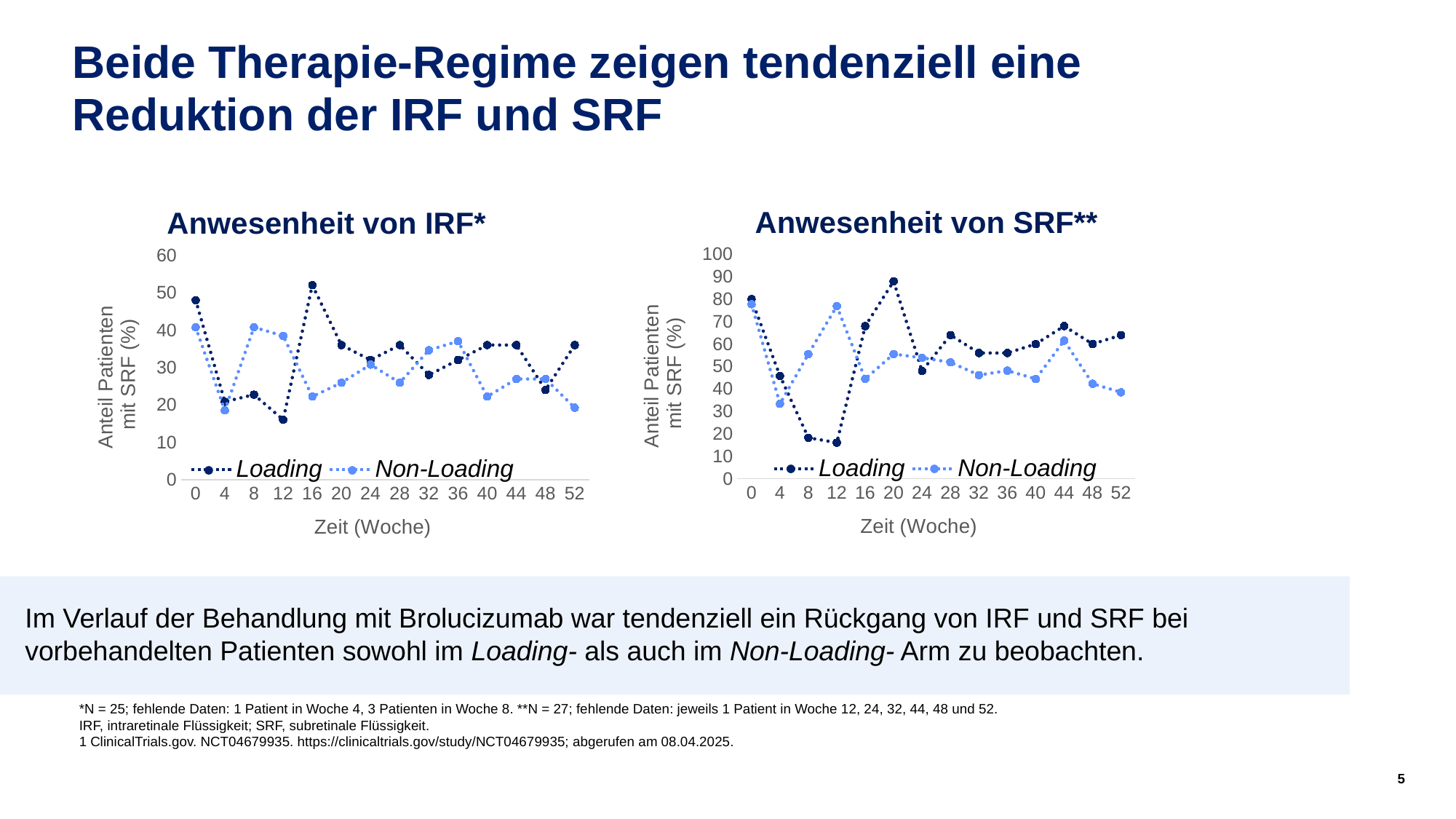
How many series does the legend of the "Anwesenheit von SRF**" chart list? 2 In the "Anwesenheit von SRF**" chart, which series has the higher value at week 12, Loading or Non-Loading? Non-Loading In the "Anwesenheit von SRF**" chart, is the Non-Loading value at week 12 greater or less than 70? greater In the "Anwesenheit von IRF*" chart, at which week does the Loading series reach its lowest value? 12 In the "Anwesenheit von IRF*" chart, is the Loading value at week 0 greater or less than 40? greater In the "Anwesenheit von IRF*" chart, at which week does the Loading series reach its highest value? 16 In the "Anwesenheit von IRF*" chart, which series has the higher value at week 16, Loading or Non-Loading? Loading What kind of chart is the "Anwesenheit von IRF*" chart? line chart How many time points are shown on the x axis of the "Anwesenheit von IRF*" chart? 14 In the "Anwesenheit von SRF**" chart, at which week does the Loading series reach its highest value? 20 What is the x-axis label of the "Anwesenheit von SRF**" chart? Zeit (Woche) In the "Anwesenheit von SRF**" chart, is the Loading value at week 20 greater or less than 80? greater